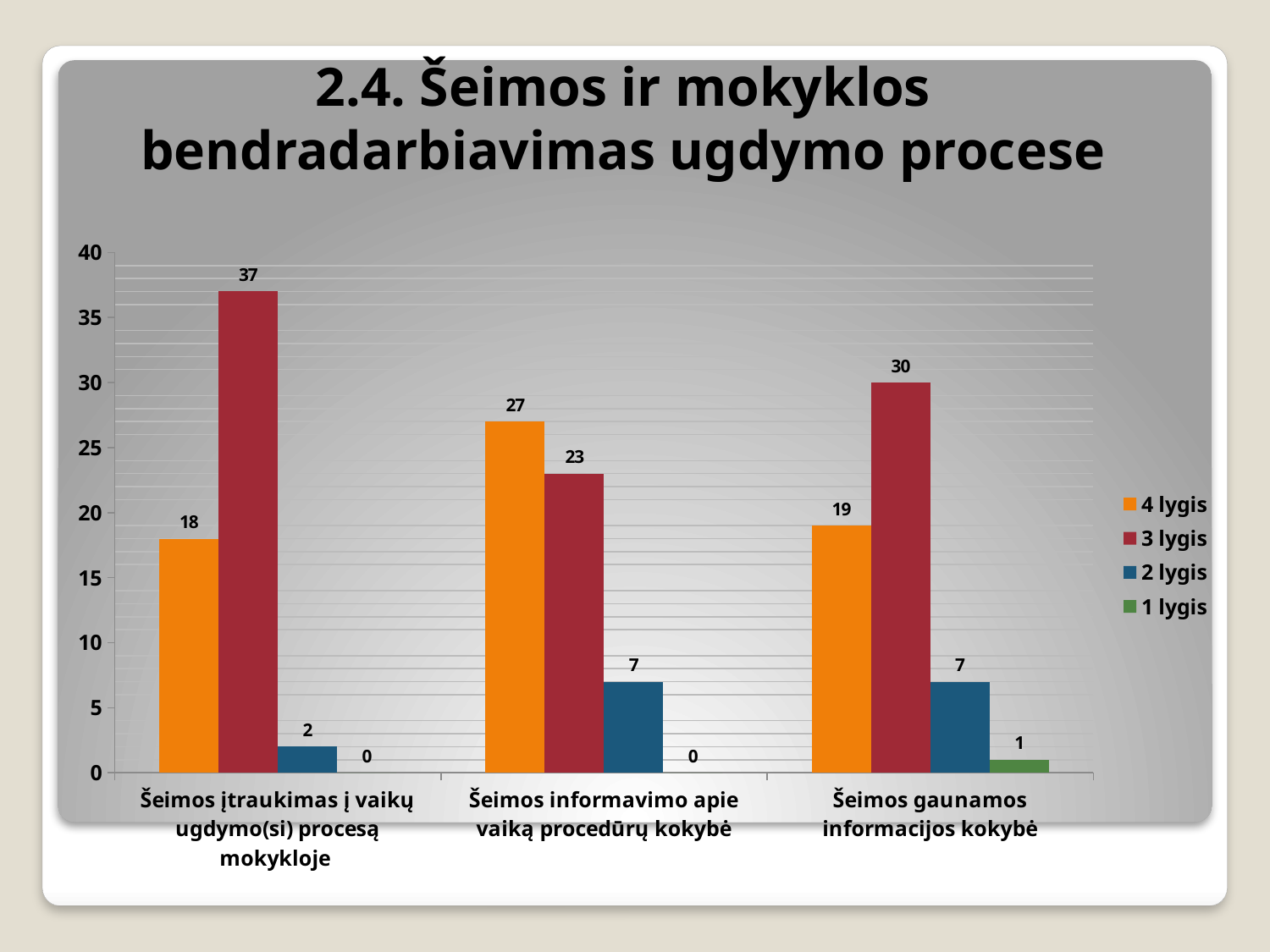
What is the difference between '3 lygis' and '4 lygis' for 'Šeimos gaunamos informacijos kokybė'? 11 Which category has the highest value for '3 lygis'? Šeimos įtraukimas į vaikų ugdymo(si) procesą mokykloje Is the value of '3 lygis' for 'Šeimos įtraukimas į vaikų ugdymo(si) procesą mokykloje' greater or less than 35? greater What is the value of '1 lygis' for 'Šeimos gaunamos informacijos kokybė'? 1 How many categories are shown on the x axis? 3 What kind of chart is shown on the slide? bar chart For 'Šeimos informavimo apie vaiką procedūrų kokybė', which is larger: '4 lygis' or '3 lygis'? 4 lygis What is the value of '4 lygis' for 'Šeimos informavimo apie vaiką procedūrų kokybė'? 27 Which category has the lowest value for '4 lygis'? Šeimos įtraukimas į vaikų ugdymo(si) procesą mokykloje What is the title of the slide? 2.4. Šeimos ir mokyklos bendradarbiavimas ugdymo procese What is the value of '3 lygis' for 'Šeimos įtraukimas į vaikų ugdymo(si) procesą mokykloje'? 37 How many series does the legend list? 4